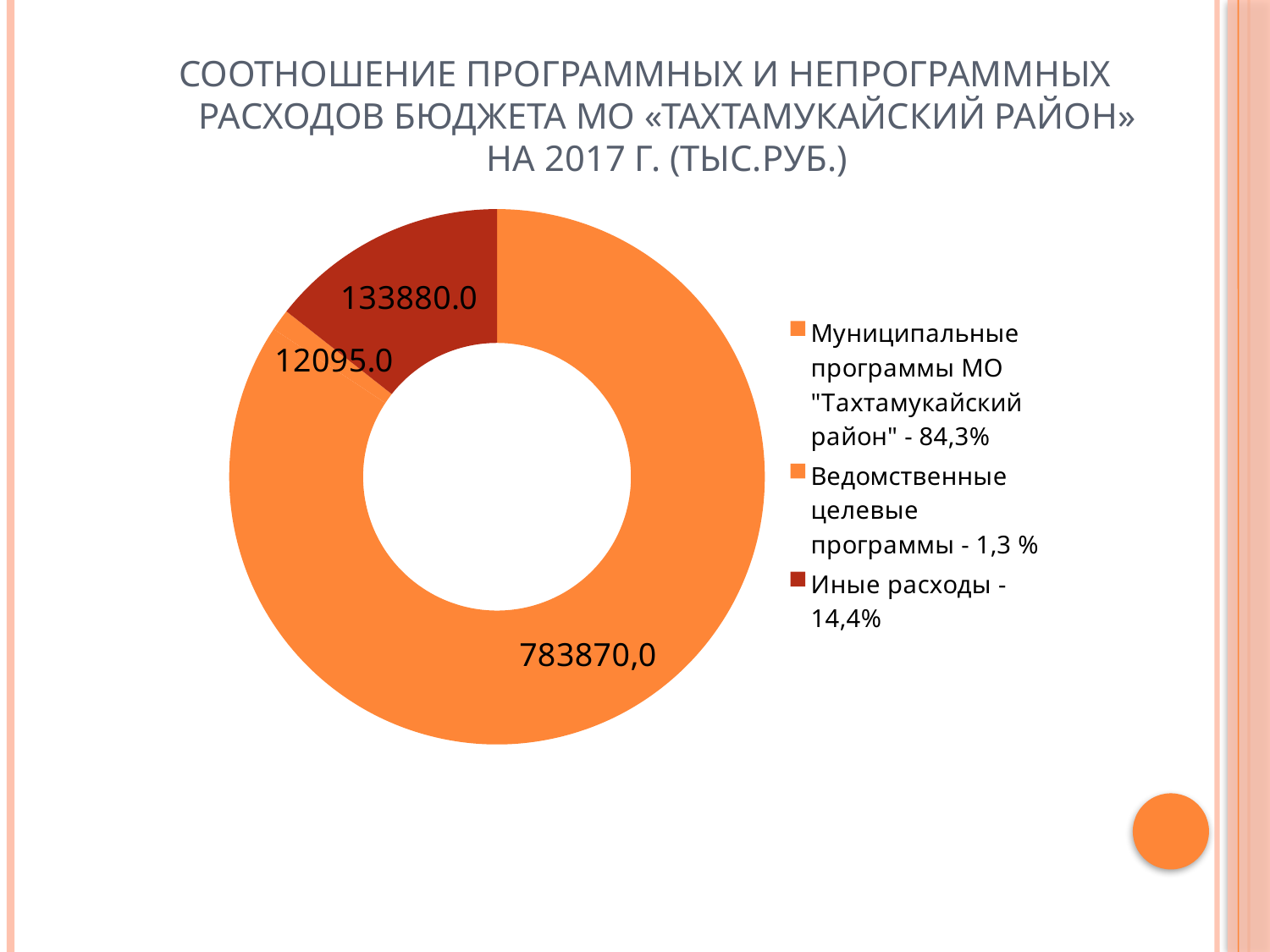
What share of the chart does "Муниципальные программы МО "Тахтамукайский район"" represent, according to the legend? 84,3% What value is shown for the slice "Иные расходы"? 133880.0 How many slices does the chart have? 3 What year does the chart title refer to? 2017 What is the difference between the values for "Иные расходы" and "Ведомственные целевые программы"? 121785.0 What value is shown for the slice "Ведомственные целевые программы"? 12095.0 What kind of chart is shown on the slide? doughnut chart Which category has the smallest slice of the chart? Ведомственные целевые программы Which is larger: the value for "Иные расходы" or the value for "Ведомственные целевые программы"? Иные расходы Which category has the largest slice of the chart? Муниципальные программы МО "Тахтамукайский район" What value is shown for the slice "Муниципальные программы МО "Тахтамукайский район""? 783870,0 What share of the chart does "Иные расходы" represent, according to the legend? 14,4%